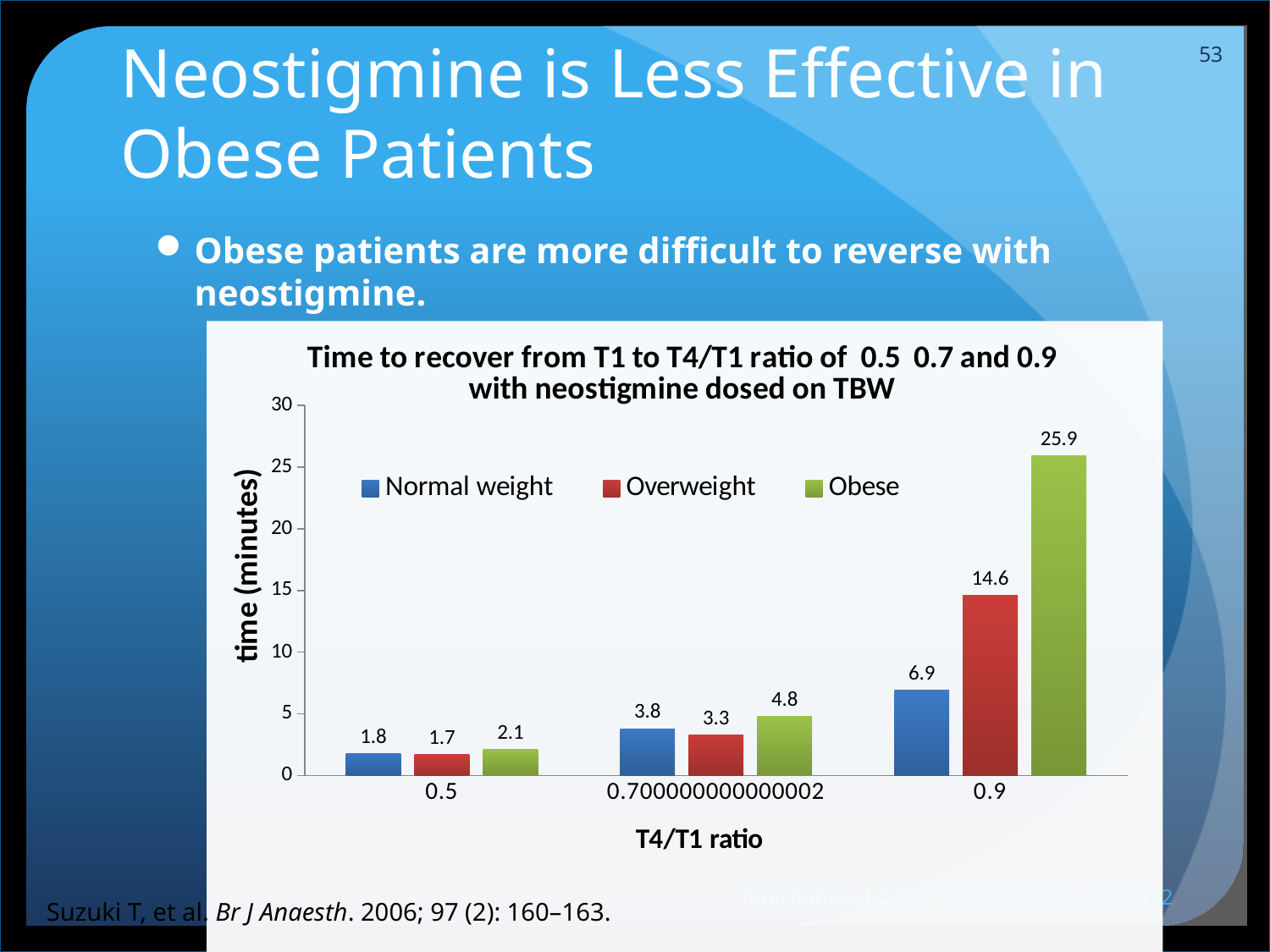
What is the time in minutes for Overweight patients at a T4/T1 ratio of 0.9? 14.6 Which weight group has the highest time at a T4/T1 ratio of 0.9? Obese Do the Obese values rise or fall as the T4/T1 ratio increases along the x axis? Rise What is the time in minutes for Obese patients at a T4/T1 ratio of 0.9? 25.9 What is the time in minutes for Obese patients in the middle category labelled 0.700000000000002? 4.8 What is the time in minutes for Normal weight patients at a T4/T1 ratio of 0.5? 1.8 What kind of chart is shown on the slide? Bar chart What is the difference in minutes between the Obese and Normal weight values at a T4/T1 ratio of 0.9? 19 At a T4/T1 ratio of 0.9, which is larger: the Overweight value or the Normal weight value? Overweight Is the Obese value at a T4/T1 ratio of 0.9 greater or less than 25? greater How many series does the legend list? 3 Which weight group has the lowest time at a T4/T1 ratio of 0.5? Overweight